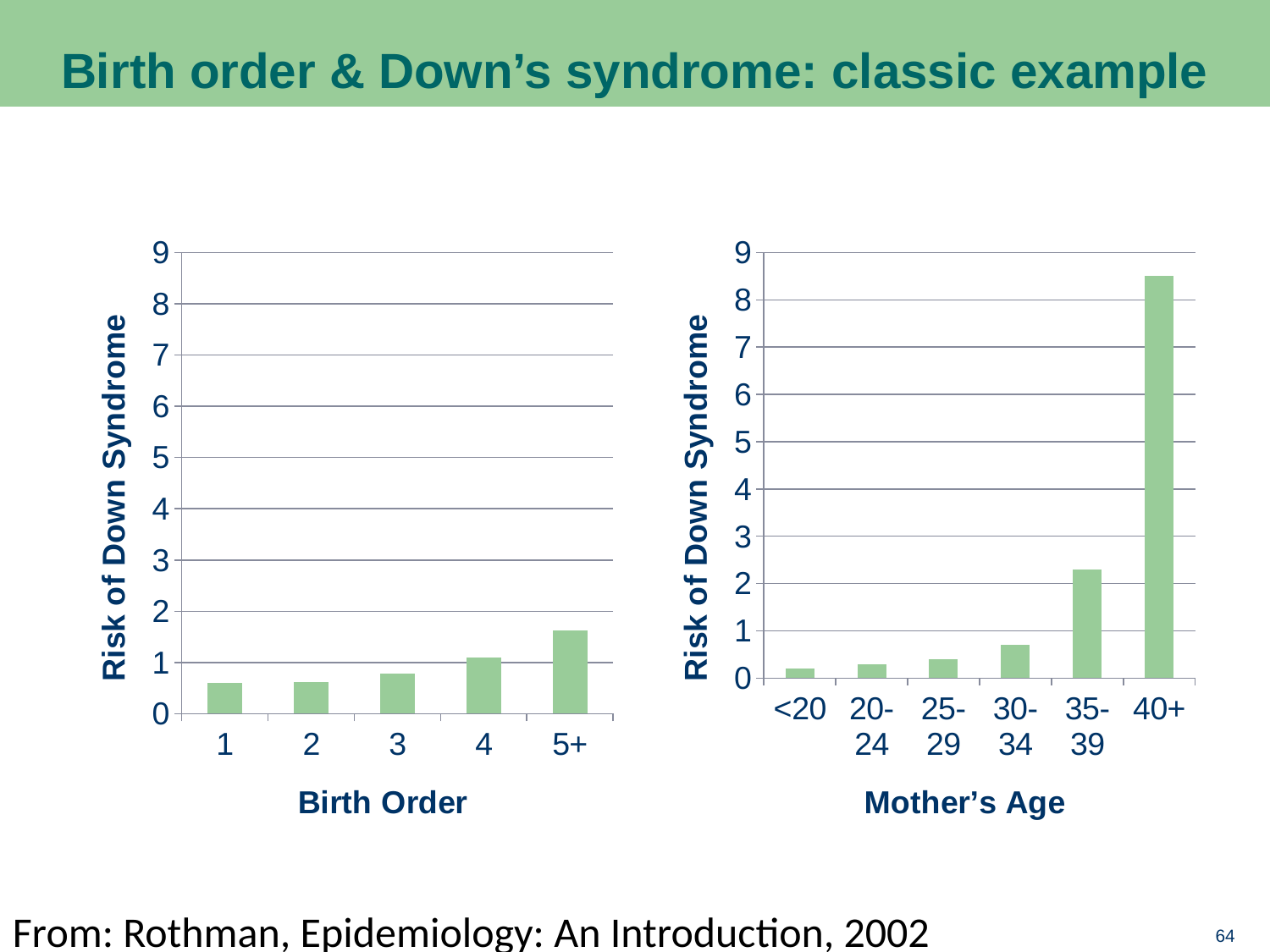
On the Birth Order chart, which birth order has the highest risk of Down syndrome? 5+ What kind of chart is the Birth Order chart on the left? bar chart On the Mother's Age chart, is the value for 35-39 greater or less than 2? greater On the Mother's Age chart, which is larger, the value for 30-34 or the value for 35-39? 35-39 On the Mother's Age chart, do the values rise or fall as mother's age increases? rise On the Birth Order chart, is the value for birth order 5+ greater or less than 1? greater What is the y-axis title of the Birth Order chart? Risk of Down Syndrome On the Mother's Age chart, which age group has the highest risk of Down syndrome? 40+ How many mother's age categories are shown on the right chart? 6 On the Mother's Age chart, is the value for 40+ greater or less than 8? greater How many birth order categories are shown on the left chart? 5